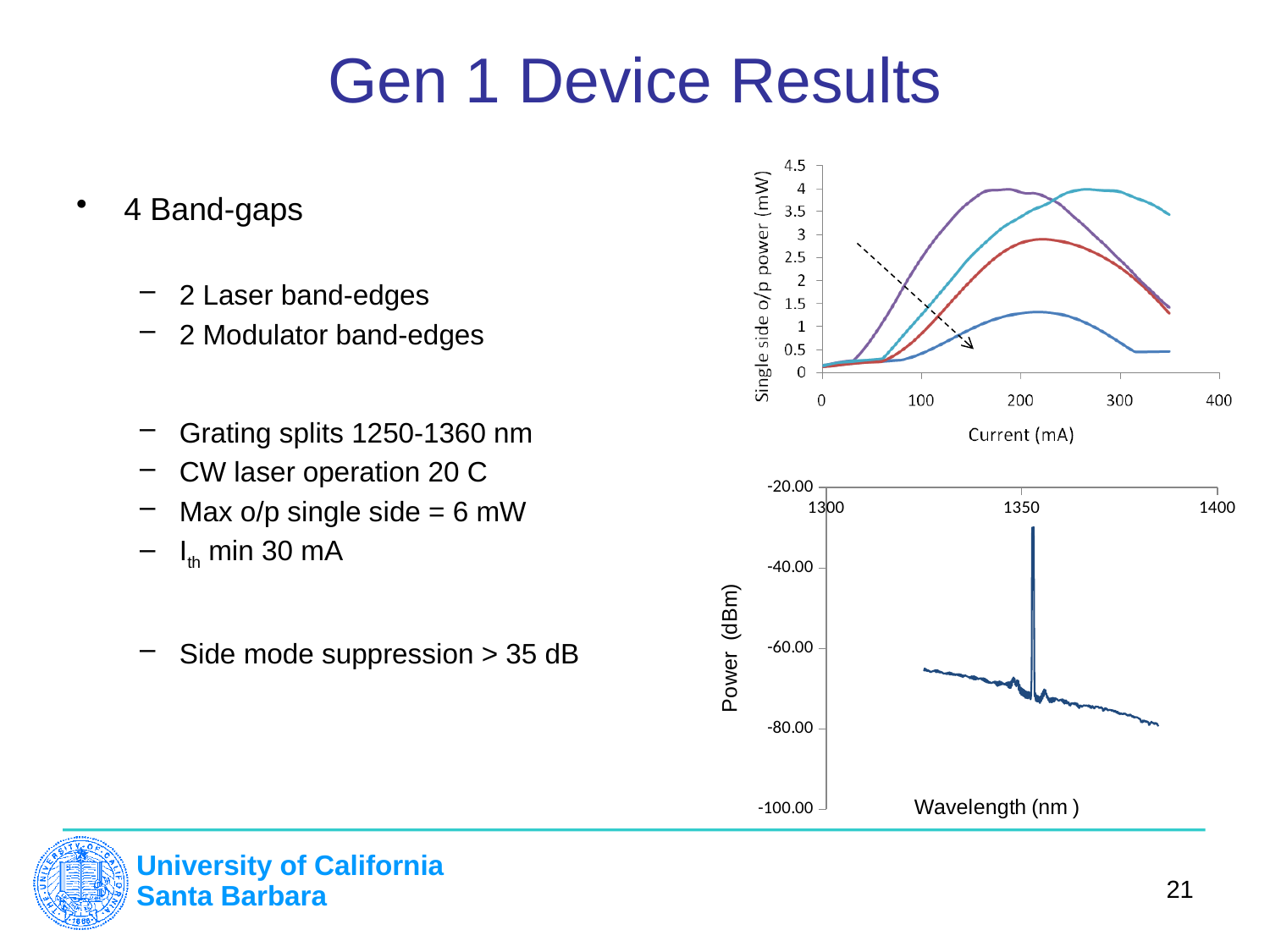
In the top chart (power versus current), what is the label of the y axis? Single side o/p power (mW) In the bottom chart (power versus wavelength), does the baseline power rise or fall as wavelength increases from 1325 nm to 1385 nm? fall How many lines are plotted in the top chart (power versus current)? 4 In the top chart (power versus current), is the value of the cyan line at 350 mA greater or less than 3? greater In the top chart (power versus current), is the peak value of the blue line greater or less than 1.5? less In the top chart (power versus current), is the peak of the red line higher or lower than the peak of the blue line? higher In the bottom chart (power versus wavelength), is the peak power greater or less than -40.00 dBm? greater In the top chart (power versus current), what is the label of the x axis? Current (mA) What kind of chart is the top chart on the slide (power versus current)? line chart In the top chart (power versus current), which line reaches the lowest peak power? the blue line What kind of chart is the bottom chart on the slide (power versus wavelength)? line chart